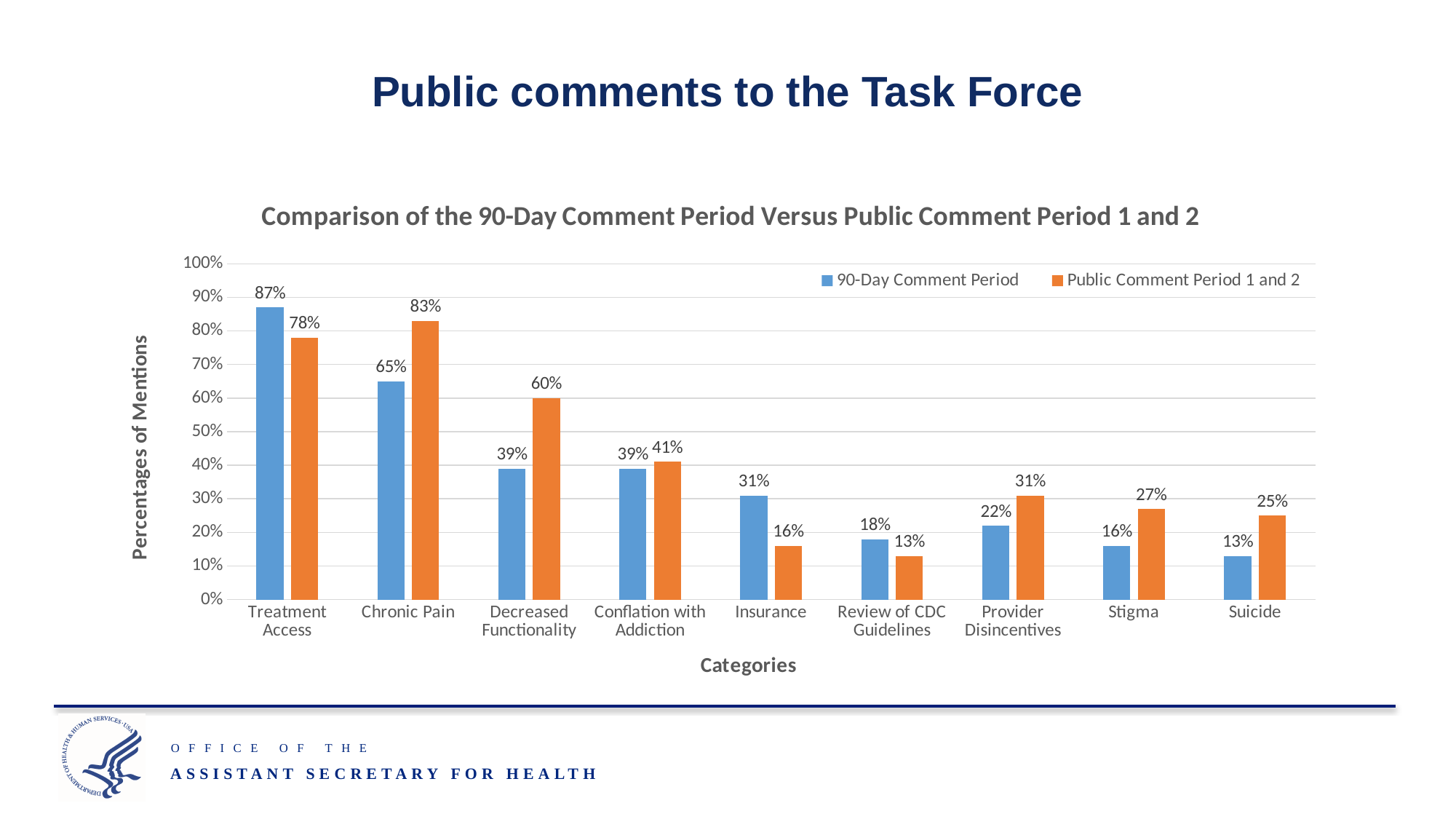
How many series does the legend list? 2 How many categories are shown on the x axis? 9 Which category has the highest value in the 90-Day Comment Period series? Treatment Access What is the title of the chart? Comparison of the 90-Day Comment Period Versus Public Comment Period 1 and 2 What is the difference between the 90-Day Comment Period and Public Comment Period 1 and 2 values for Decreased Functionality? 21% What is the value for Chronic Pain in the Public Comment Period 1 and 2 series? 83% Which category has the lowest value in the Public Comment Period 1 and 2 series? Review of CDC Guidelines What is the label of the y axis? Percentages of Mentions For Insurance, which series has the larger value: 90-Day Comment Period or Public Comment Period 1 and 2? 90-Day Comment Period What is the value for Treatment Access in the 90-Day Comment Period series? 87% What is the value for Stigma in the 90-Day Comment Period series? 16% What kind of chart is shown on the slide? Bar chart